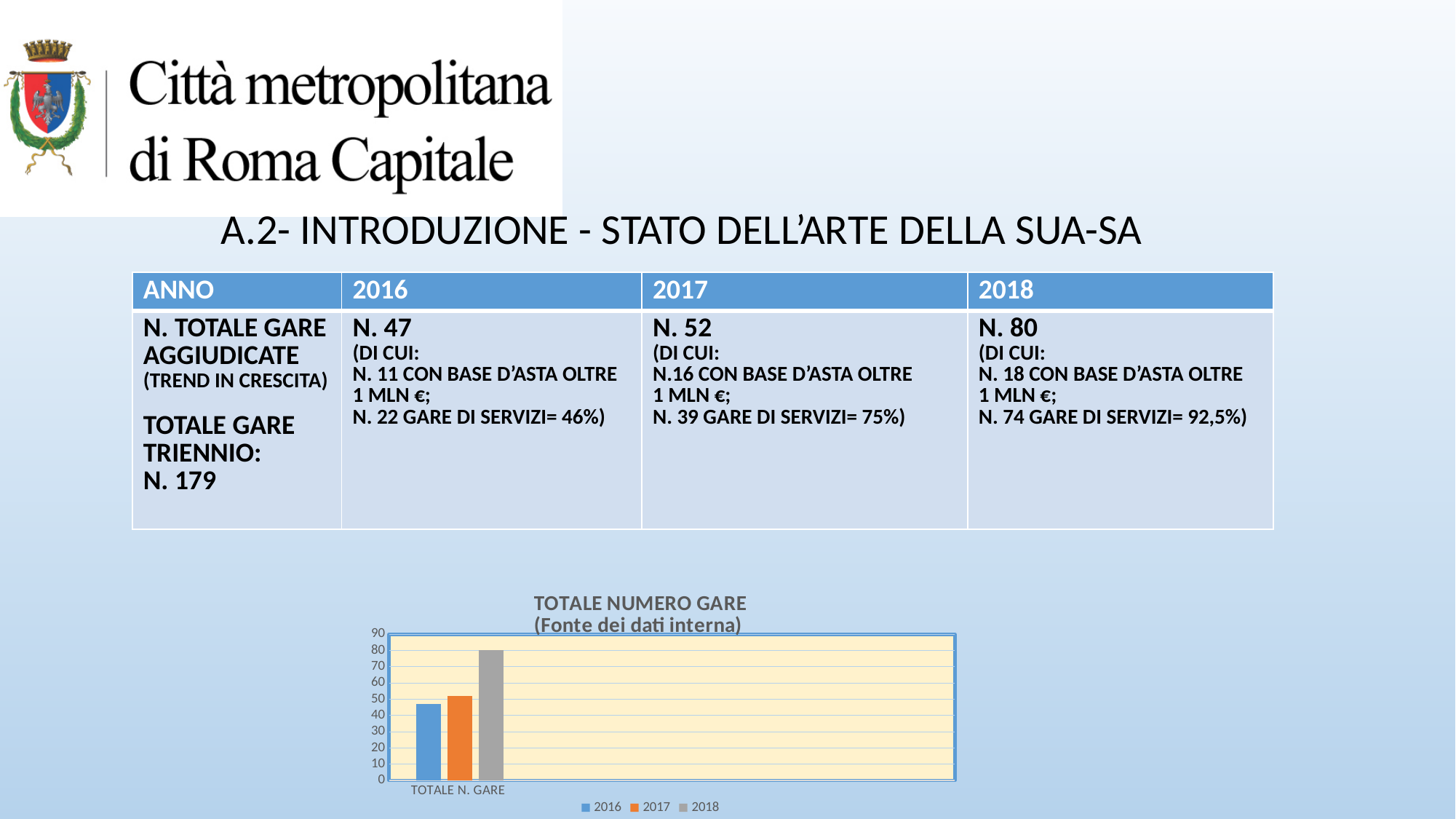
Do the bar values rise or fall from 2016 to 2018? rise What kind of chart is shown on the slide? bar chart What is the label of the category on the x axis? TOTALE N. GARE What is the title of the chart? TOTALE NUMERO GARE (Fonte dei dati interna) Which is larger in the chart, the 2016 bar or the 2017 bar? 2017 How many categories are shown on the x axis of the chart? 1 Which series has the lowest bar in the chart? 2016 How many series does the chart legend list? 3 What is the value of the 2018 bar in the chart? 80 Which series has the highest bar in the chart? 2018 Is the value for 2016 greater or less than 50? less Is the value for 2017 greater or less than 50? greater